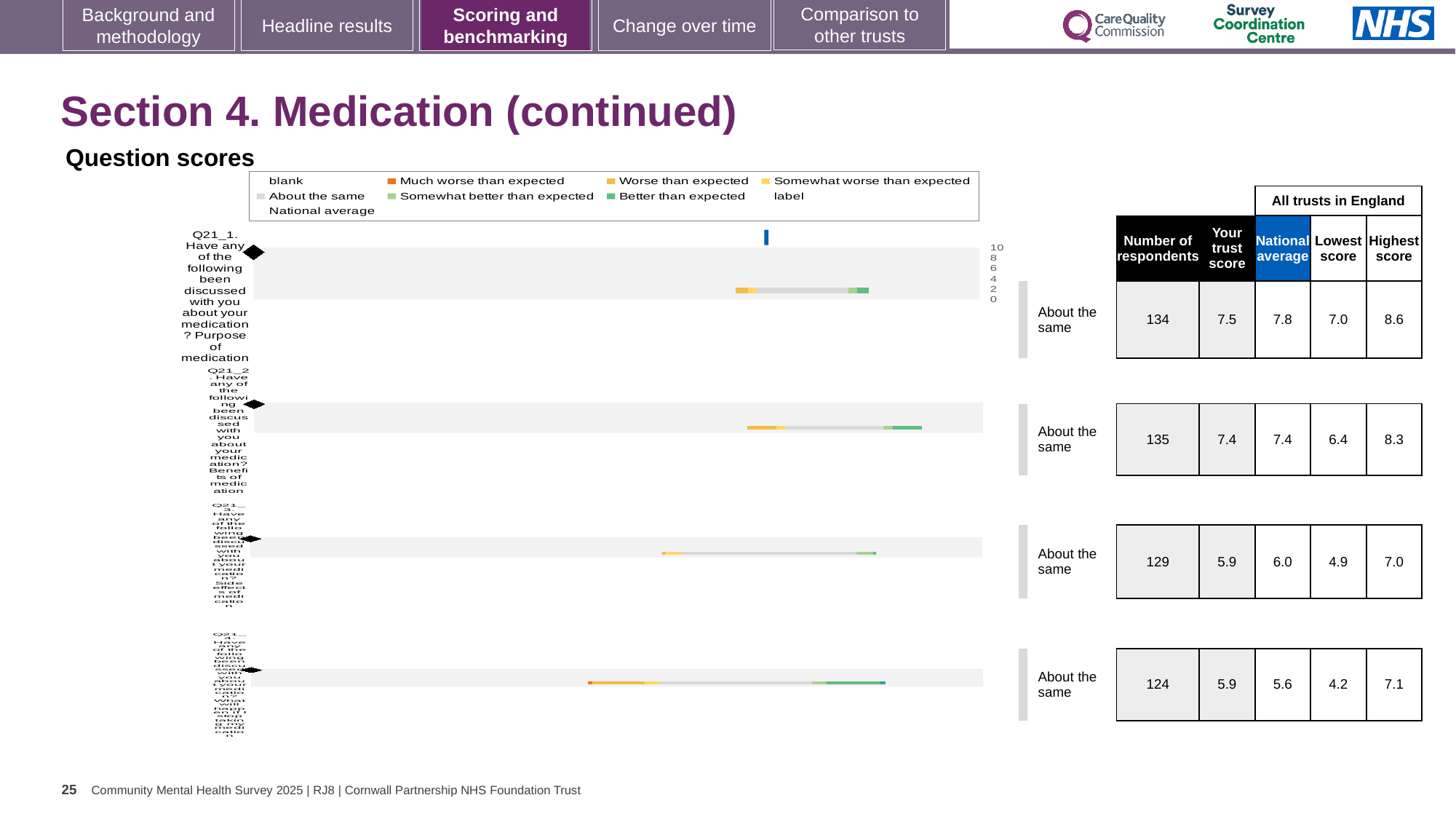
What is the number of respondents for the fourth row (Q21_4)? 124 What is the national average for Q21_1 (Purpose of medication), the first row? 7.8 For the first row (Q21_1), how much higher is the national average than the trust score? 0.3 What kind of chart is used to show the question scores on this slide? Bar chart What is the trust score for Q21_1 (Purpose of medication), the first row? 7.5 For the fourth row (Q21_4), is the trust score or the national average larger? Trust score (5.9) What is the national average for the third row (Q21_3)? 6.0 What is the number of respondents for Q21_1 (Purpose of medication), the first row? 134 Which row has the highest value in the 'Highest score' column? Q21_1 (first row), 8.6 How many questions (bars) are plotted in the question scores chart? 4 What benchmark category is shown for all four questions on this slide? About the same What is the lowest value shown in the 'Lowest score' column? 4.2